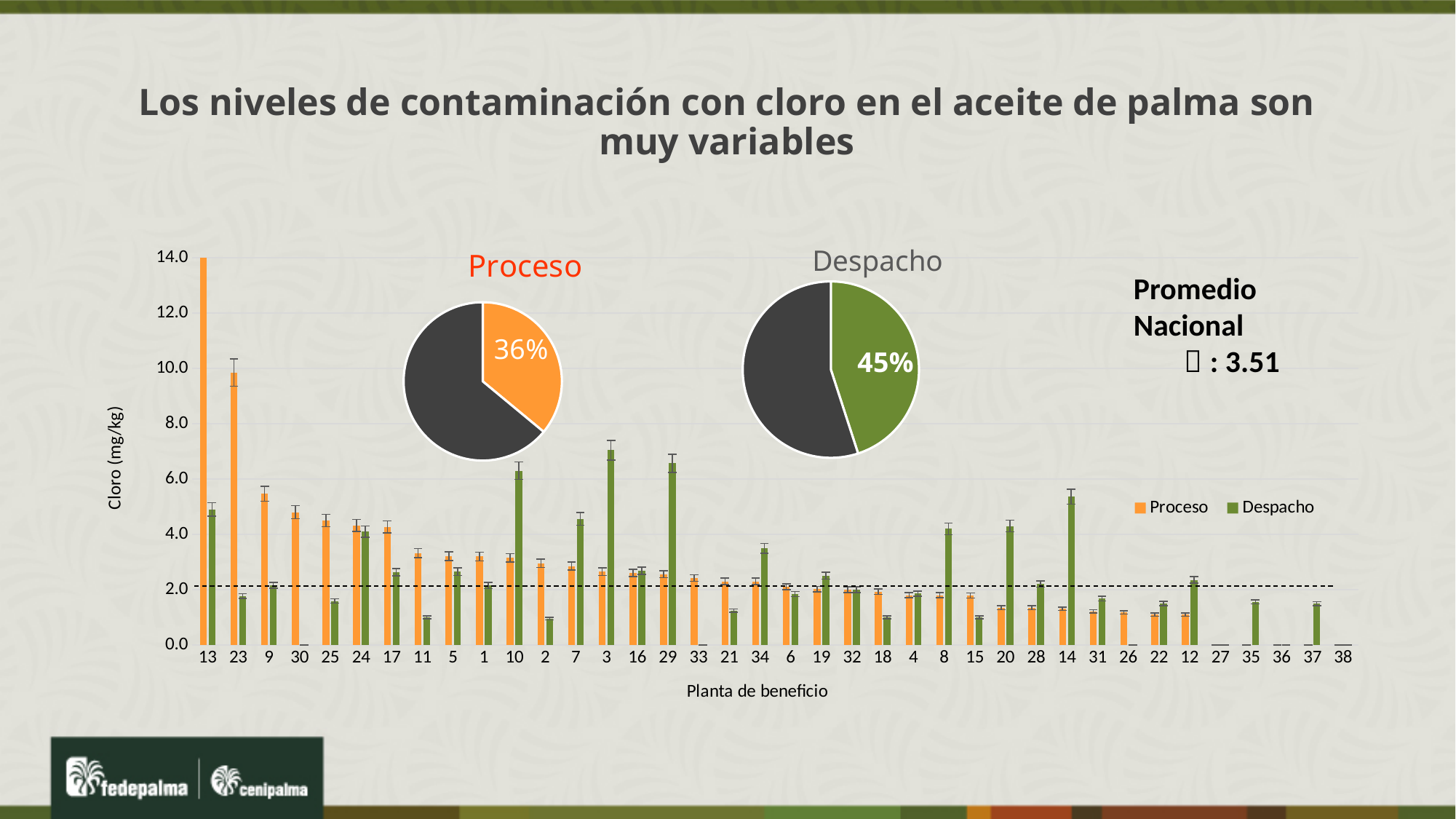
In the Despacho pie chart, what percentage is shown for the green slice? 45% In the bar chart, for plant 13, which is larger: the Proceso value or the Despacho value? Proceso In the bar chart, is the Proceso value for plant 23 greater or less than 8.0? greater What kind of chart is the large chart showing chlorine levels by plant? bar chart What is the label of the y axis of the bar chart? Cloro (mg/kg) In the bar chart, for plant 29, which is larger: the Proceso value or the Despacho value? Despacho In the bar chart, which plant has the highest Proceso value? 13 In the Proceso pie chart, what percentage is shown for the orange slice? 36% In the bar chart, which plant has the highest Despacho value? 3 How many series does the legend of the bar chart list? 2 How many plants (categories) are shown on the x axis of the bar chart? 38 In the bar chart, is the Despacho value for plant 2 greater or less than 2.0? less